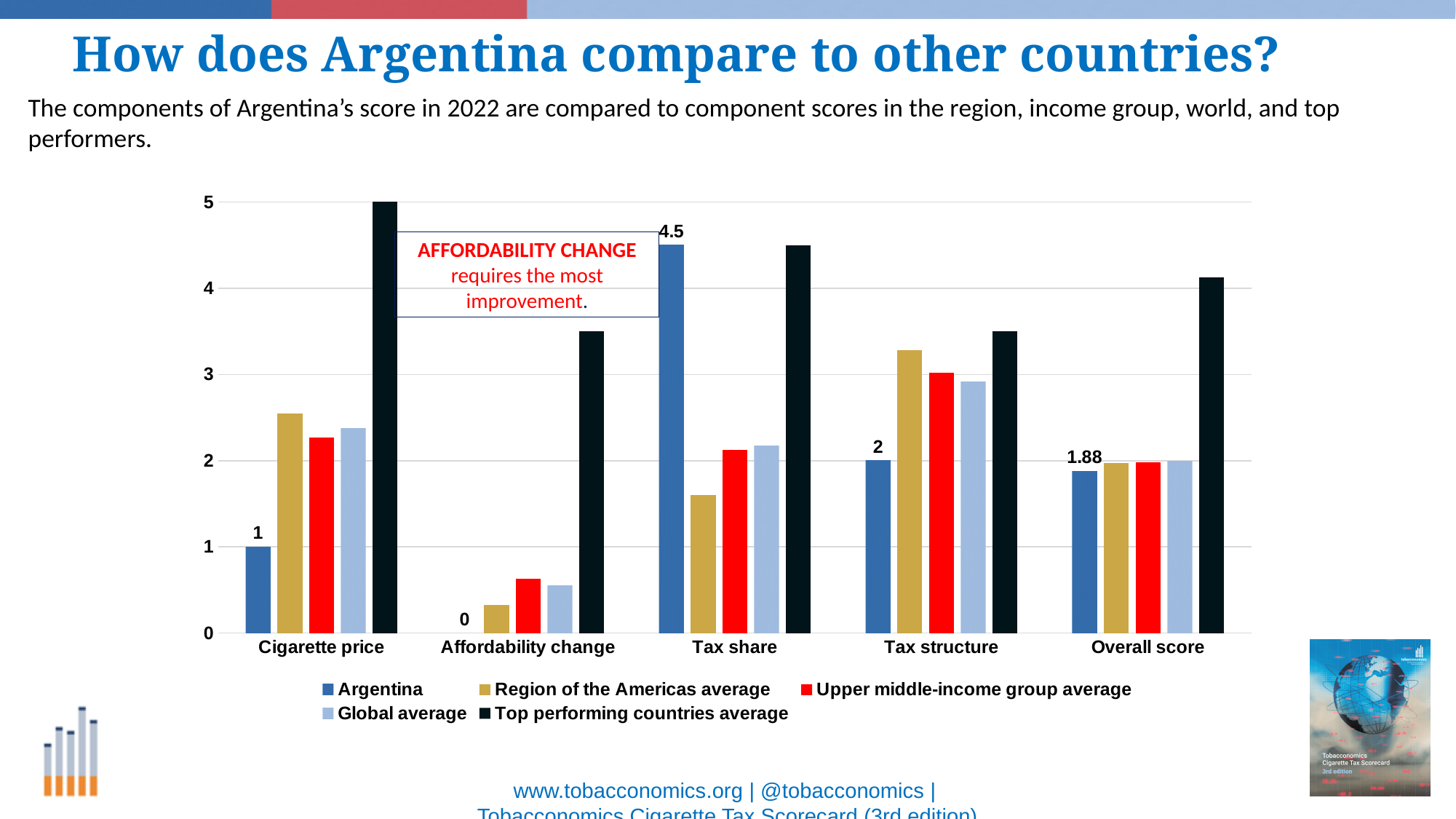
Which component has Argentina's highest score? Tax share Which component has Argentina's lowest score? Affordability change How many series does the legend list? 5 Is the Global average for Affordability change greater or less than 1? less What kind of chart is shown on the slide? bar chart For Tax structure, which is larger: Argentina or the Region of the Americas average? Region of the Americas average What is the Top performing countries average for Cigarette price? 5 What is Argentina's Overall score? 1.88 What is Argentina's score for Affordability change? 0 What is the difference between Argentina's Tax share score and its Cigarette price score? 3.5 What is Argentina's score for Tax share? 4.5 Is the Top performing countries average for Affordability change greater or less than 3? greater